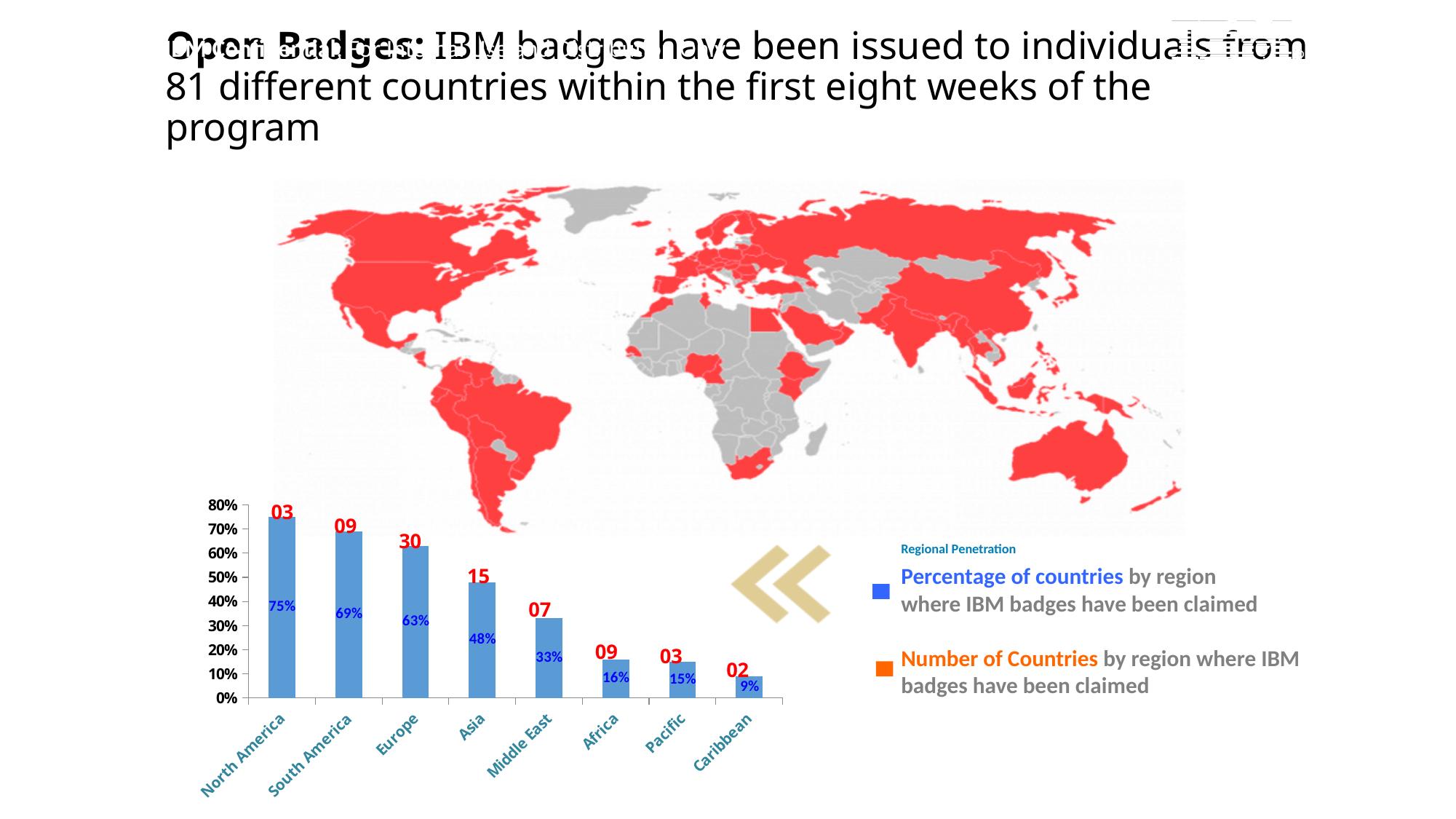
Which region has the largest number of countries (red label) where IBM badges have been claimed? Europe What percentage of countries in Europe have claimed IBM badges according to the bar chart? 63% What is the percentage value shown for the Middle East bar? 33% Which region has the highest percentage of countries where IBM badges have been claimed? North America How many countries in Asia are shown (red number above the bar) where IBM badges have been claimed? 15 What is the difference in percentage points between North America and South America? 6% Do the percentage values rise or fall moving from left to right along the x axis? Fall How many regions are shown on the x axis of the bar chart? 8 Which region has the lowest percentage of countries where IBM badges have been claimed? Caribbean How many entries does the Regional Penetration legend list? 2 Which has a higher percentage, Asia or Africa? Asia What type of chart is used to show regional penetration? Bar chart